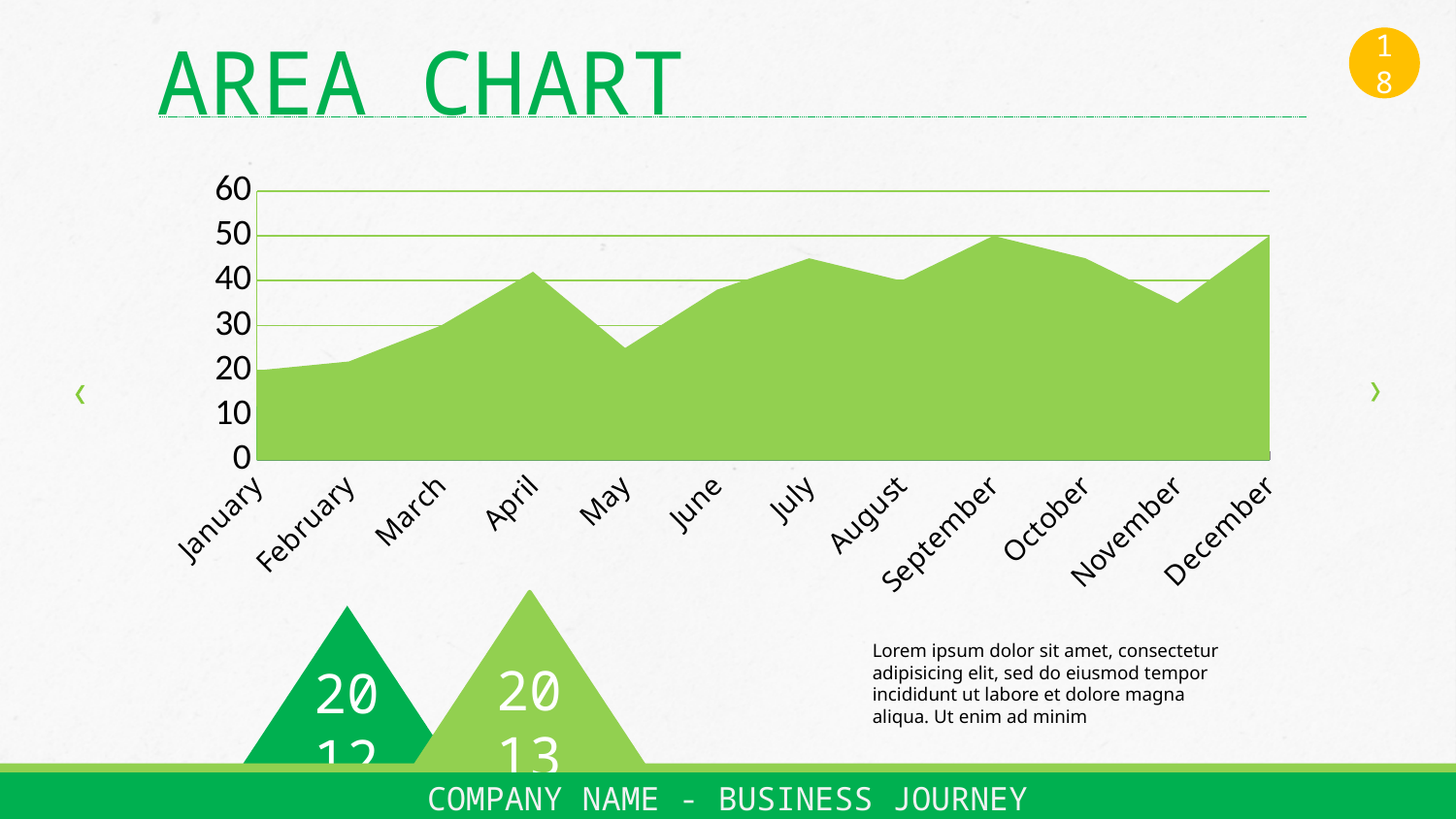
What is the title of the slide containing the chart? AREA CHART How many months are plotted along the x axis of the chart? 12 What kind of chart is shown on the slide? area chart Which is larger, the value for July or the value for November? July Is the value for May greater or less than 30? less Is the value for June greater or less than 30? greater Do the values rise or fall from January to April? rise Is the value for November greater or less than 40? less What is the value for January? 20 Which is larger, the value for April or the value for May? April What is the value for September? 50